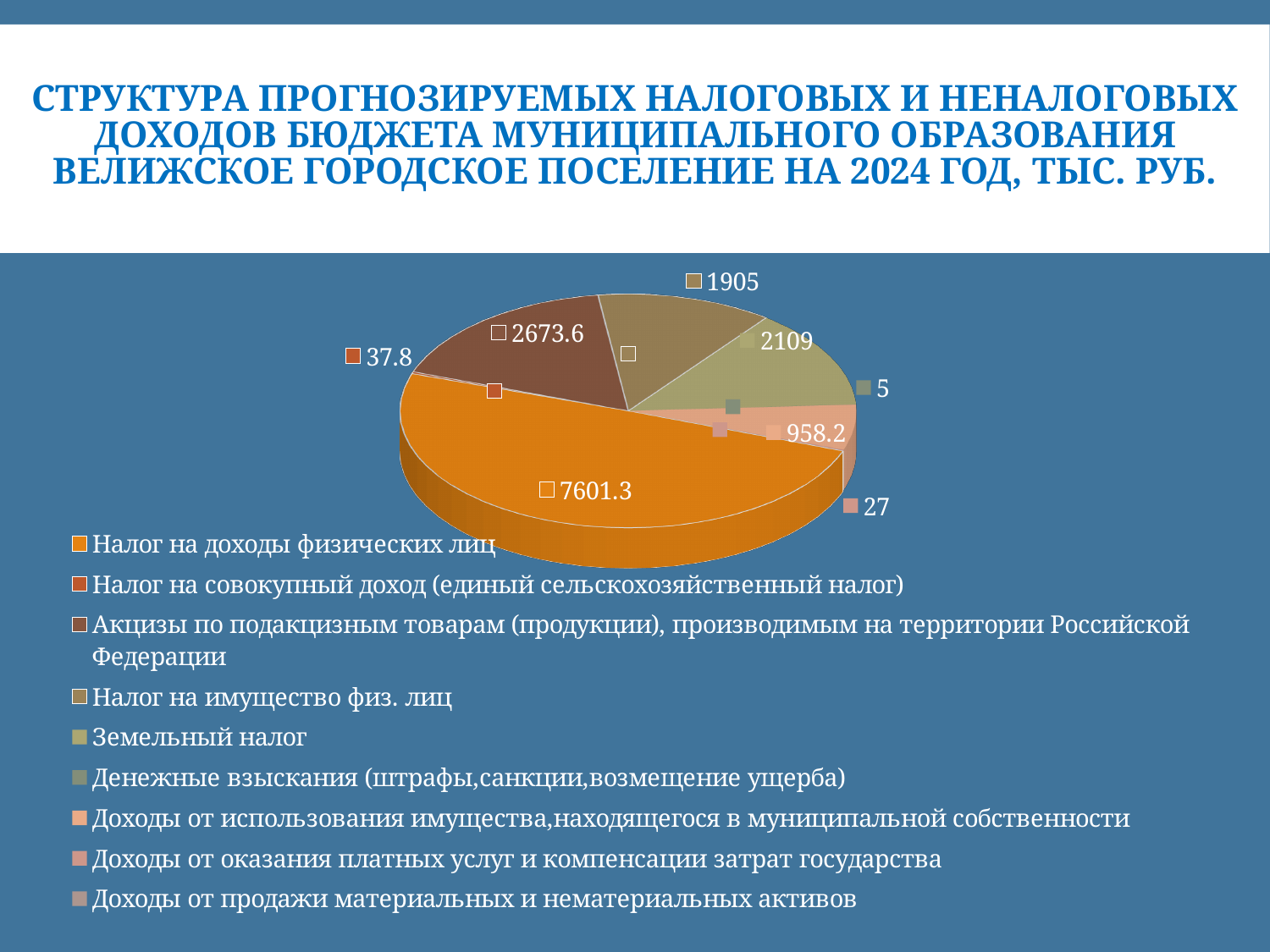
What kind of chart is shown on the slide? Pie chart Which category has the largest slice of the pie? Налог на доходы физических лиц What is the value for Налог на доходы физических лиц? 7601.3 What is the value for Налог на имущество физ. лиц? 1905 How many categories does the legend list? 9 What is the value for Доходы от использования имущества, находящегося в муниципальной собственности? 958.2 What is the difference between Земельный налог and Налог на имущество физ. лиц? 204 What is the value for Налог на совокупный доход (единый сельскохозяйственный налог)? 37.8 Which is larger, Земельный налог or Налог на имущество физ. лиц? Земельный налог What is the value for Земельный налог? 2109 What year does the chart title refer to? 2024 What is the value for Акцизы по подакцизным товарам (продукции), производимым на территории Российской Федерации? 2673.6